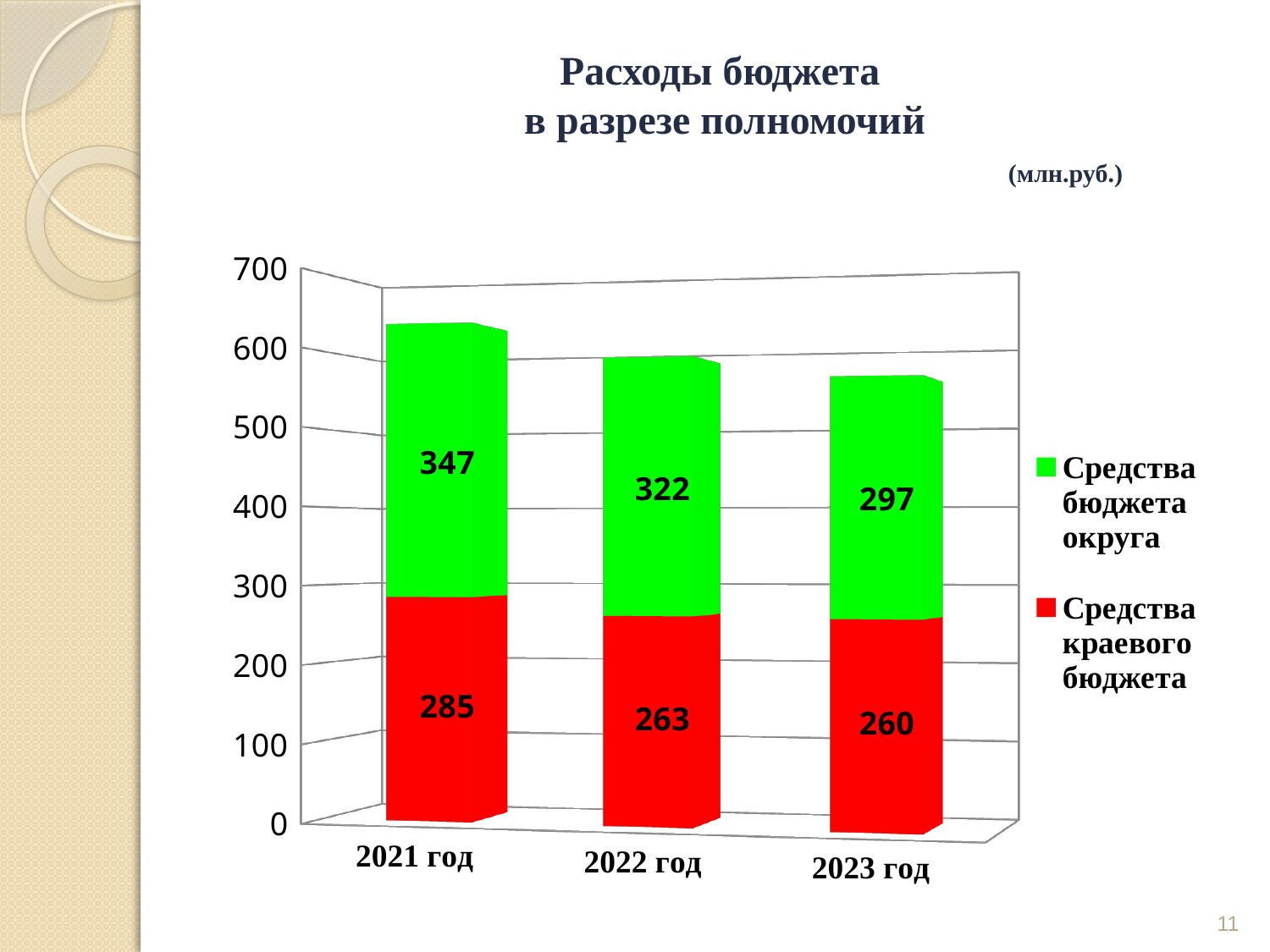
What is the value of Средства краевого бюджета for 2022 год? 263 What is the difference between Средства бюджета округа in 2021 год and 2023 год? 50 How many years are shown on the x axis? 3 Which year has the lowest value for Средства краевого бюджета? 2023 год How many series does the legend list? 2 Which is larger: Средства краевого бюджета in 2021 год or in 2022 год? 2021 год What is the total of the stacked bar for 2022 год? 585 Which year has the highest value for Средства бюджета округа? 2021 год What is the value of Средства краевого бюджета for 2023 год? 260 What is the value of Средства бюджета округа for 2021 год? 347 Does the value of Средства бюджета округа rise or fall from 2021 год to 2023 год? fall What is the total of the stacked bar for 2021 год? 632